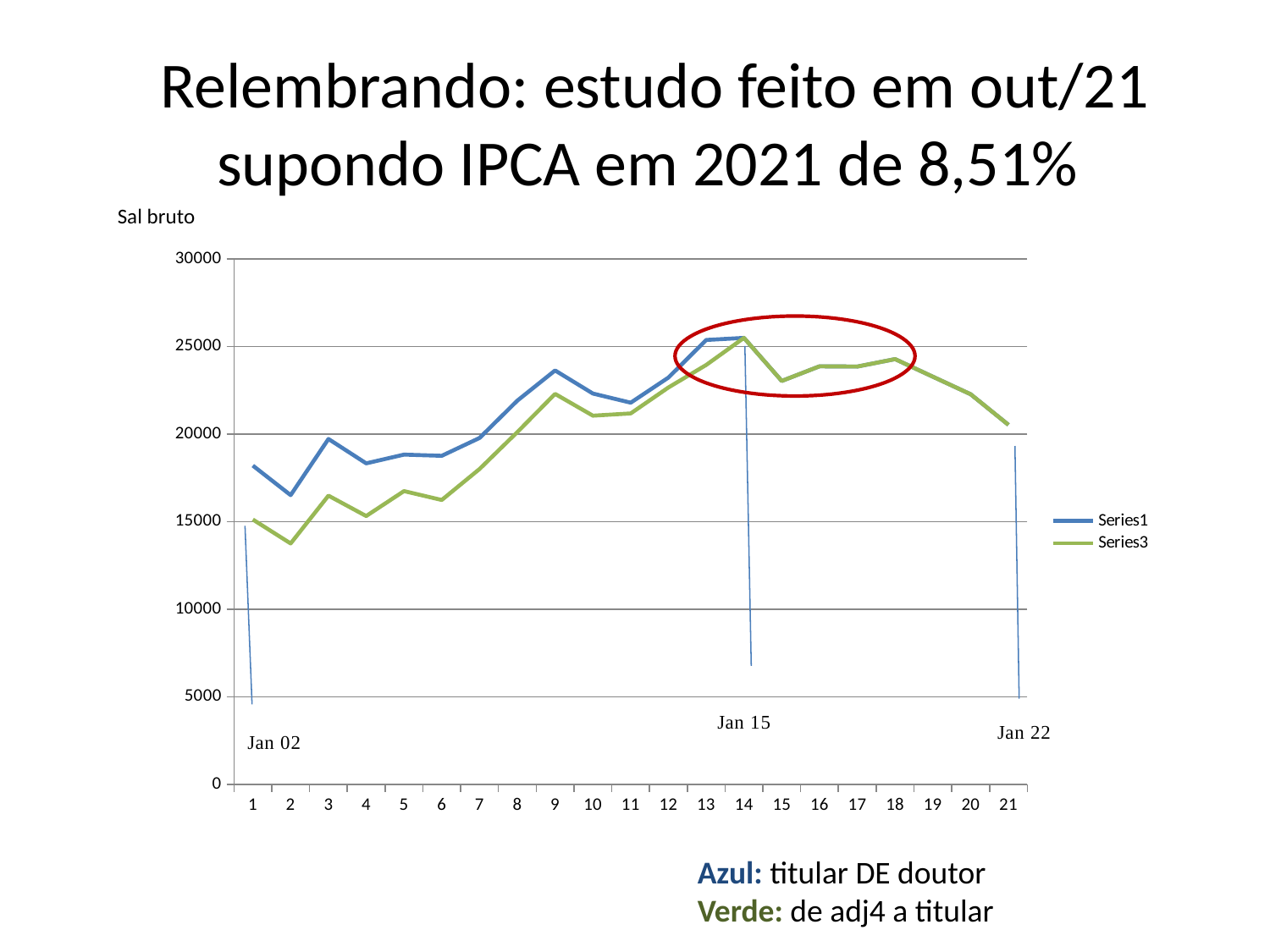
What is the title of the chart? Sal bruto At point 5, which series has the larger value, Series1 or Series3? Series1 At which point does Series3 reach its lowest value? 2 How many points are plotted along the x axis for each series? 21 Which series is drawn in green according to the legend? Series3 Do the values of Series3 rise or fall from point 18 to point 21? fall Is the value of Series1 at point 9 greater or less than 20000? greater Is the value of Series3 at point 2 greater or less than 15000? less Is the value of Series1 at point 1 greater or less than 15000? greater What kind of chart is shown on the slide? line chart How many series does the legend list? 2